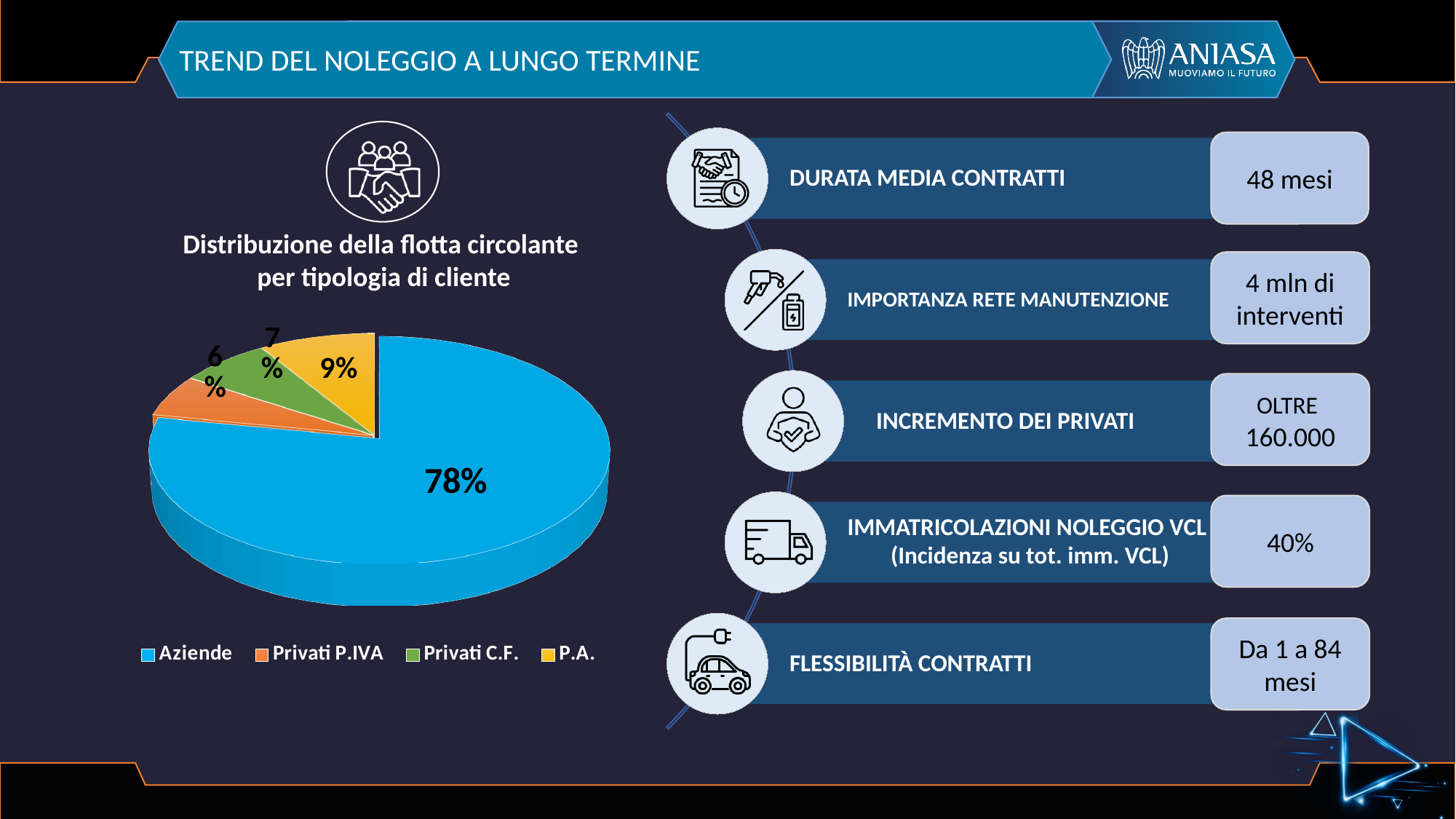
What share of the pie does Privati C.F. hold? 7% What share of the pie does P.A. hold? 9% How many categories does the pie chart show? 4 What is the difference in percentage points between Aziende and P.A.? 69 What colour is the Aziende slice in the pie chart? Blue Which is larger, the slice for P.A. or the slice for Privati C.F.? P.A. Which category has the largest slice of the pie? Aziende Which category has the smallest slice of the pie? Privati P.IVA What is the title of the pie chart? Distribuzione della flotta circolante per tipologia di cliente What type of chart is shown on the slide? Pie chart What share of the pie does Privati P.IVA hold? 6% What share of the pie does Aziende hold? 78%